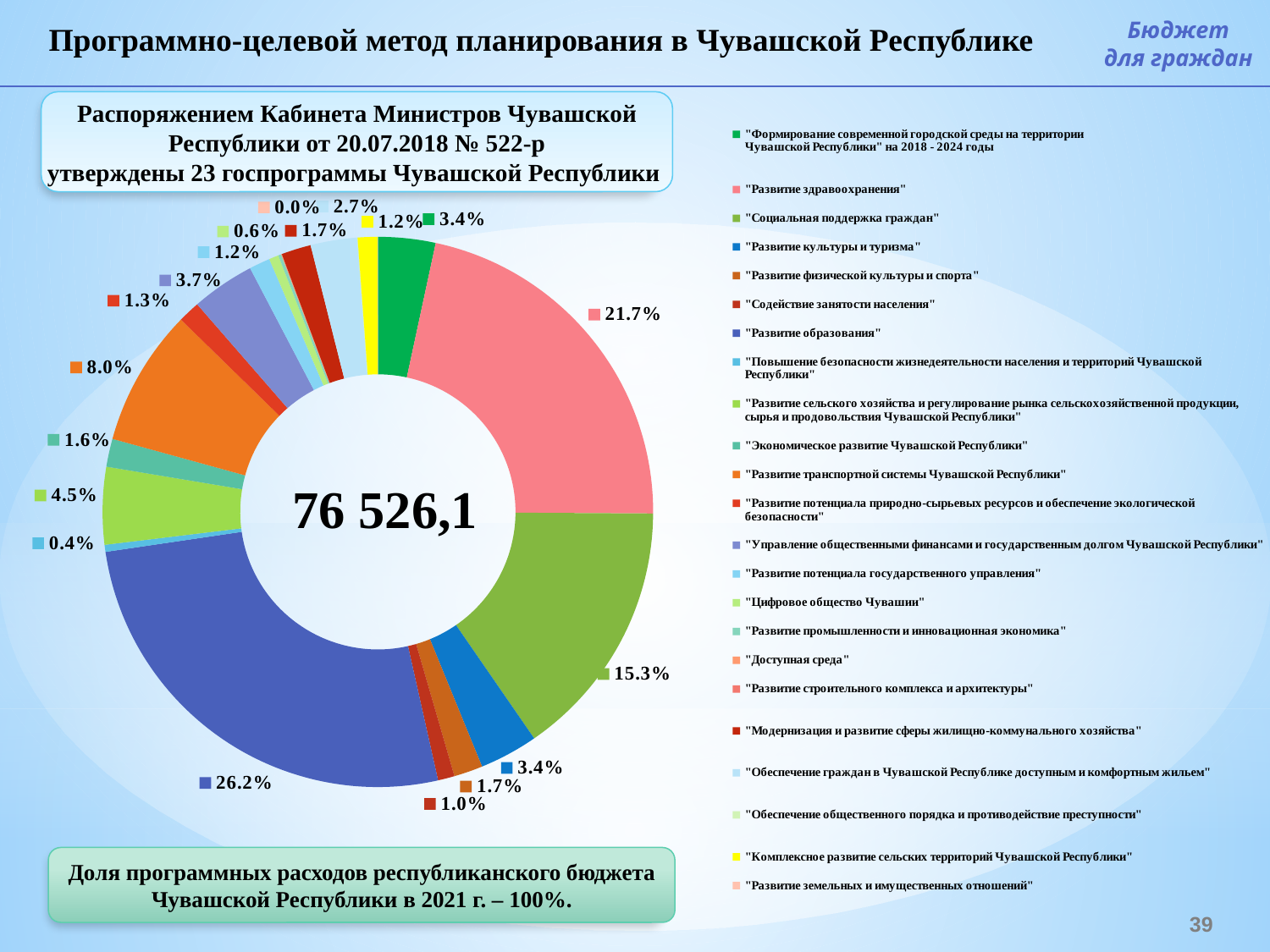
Which programme has the largest share in the chart? "Развитие образования" What value is printed in the centre of the doughnut chart? 76 526,1 How many programmes (legend entries) does the chart show? 23 What is the share for "Развитие образования"? 26.2% Which is larger: the share for "Развитие здравоохранения" or for "Социальная поддержка граждан"? "Развитие здравоохранения" What is the share for "Развитие здравоохранения"? 21.7% What is the share for "Социальная поддержка граждан"? 15.3% What is the share for "Управление общественными финансами и государственным долгом Чувашской Республики"? 3.7% What is the share for "Развитие сельского хозяйства и регулирование рынка сельскохозяйственной продукции, сырья и продовольствия Чувашской Республики"? 4.5% By how many percentage points does the share for "Развитие образования" exceed the share for "Развитие здравоохранения"? 4.5 percentage points What is the share for "Развитие транспортной системы Чувашской Республики"? 8.0% What kind of chart is shown on the slide? Pie (doughnut) chart